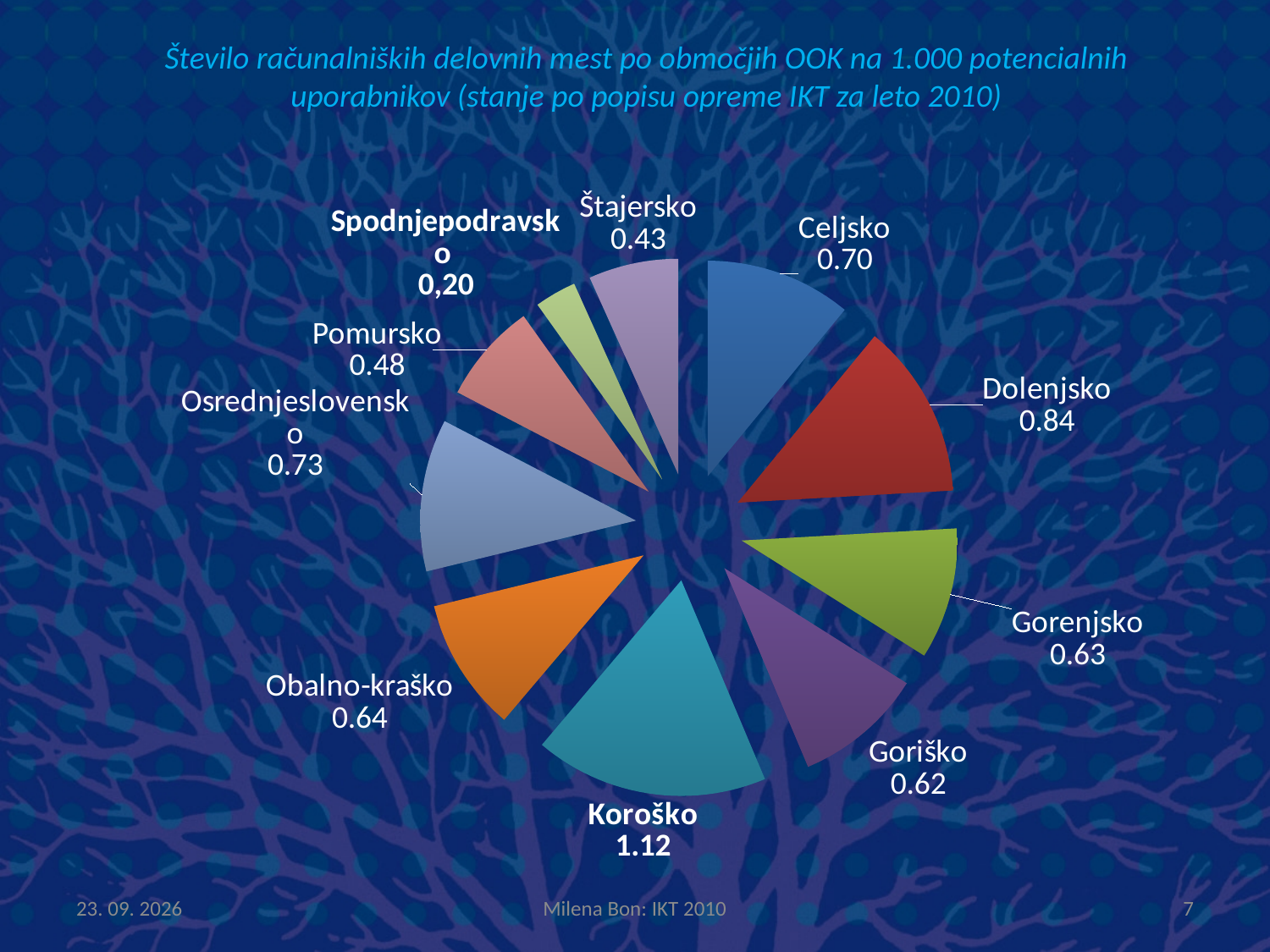
Which has a larger value, Osrednjeslovensko or Štajersko? Osrednjeslovensko What is the value for Dolenjsko? 0.84 What is the value for Koroško? 1.12 How many regions (slices) are shown in the pie chart? 10 What is the value for Spodnjepodravsko? 0,20 What kind of chart is shown on the slide? pie chart What is the value for Pomursko? 0.48 What is the difference between the values for Dolenjsko and Celjsko? 0.14 What is the value for Obalno-kraško? 0.64 Which region has the highest value in the pie chart? Koroško Which region has the lowest value in the pie chart? Spodnjepodravsko What is the difference between the values for Koroško and Spodnjepodravsko? 0.92